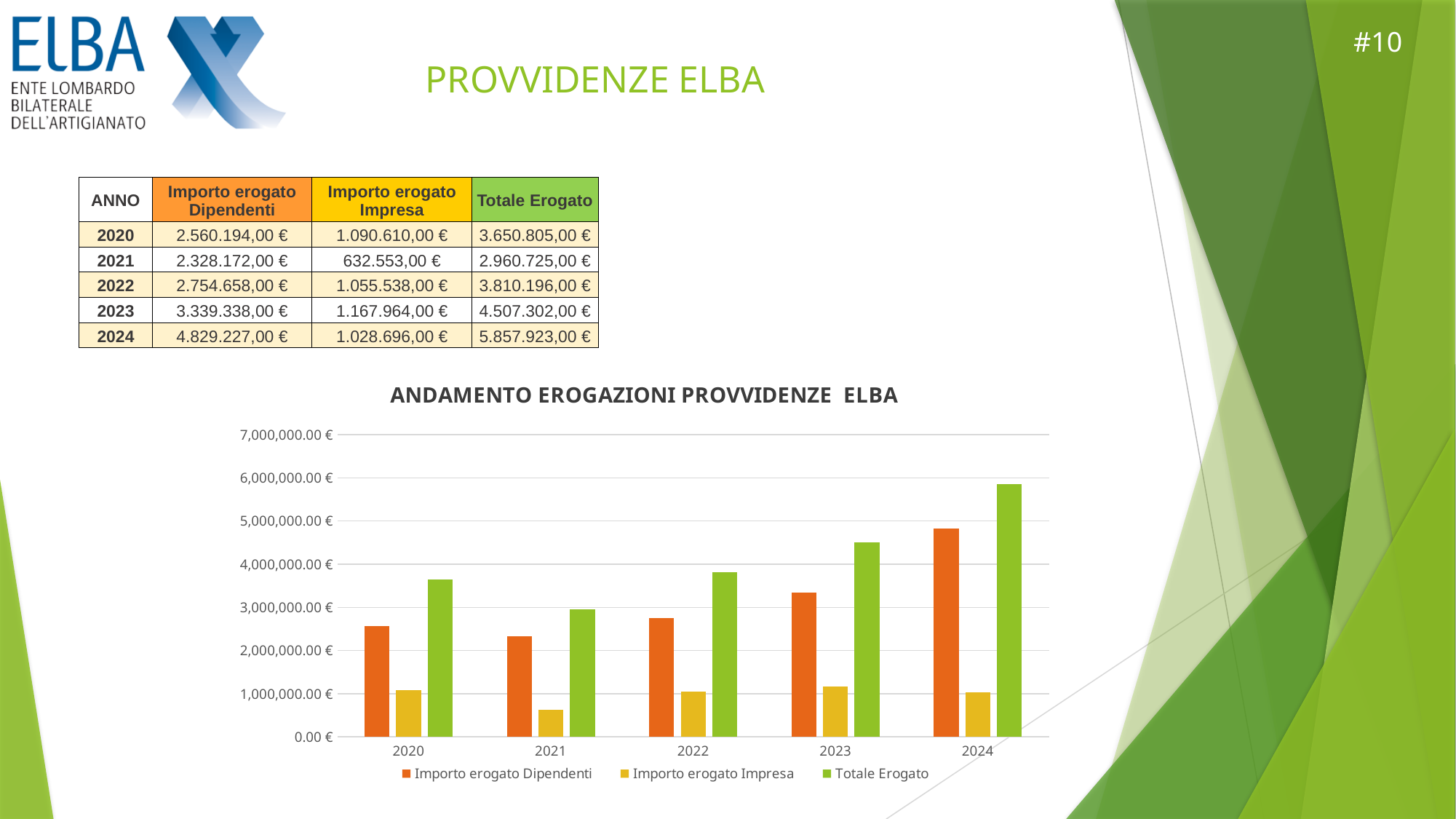
In which year is the Totale Erogato bar the lowest? 2021 How many series does the legend of the chart list? 3 What kind of chart is shown under the title "ANDAMENTO EROGAZIONI PROVVIDENZE ELBA"? Bar chart What is the Totale Erogato value for 2024, as printed in the table on the slide? 5.857.923,00 € Is the Importo erogato Impresa value for 2021 greater or less than 1,000,000.00 €? less In which year is the Importo erogato Impresa bar the lowest? 2021 In which year is the Totale Erogato bar the highest? 2024 Which is larger in 2023: Importo erogato Dipendenti or Importo erogato Impresa? Importo erogato Dipendenti How many years are shown on the x axis of the chart? 5 What is the Importo erogato Dipendenti value for 2020, as printed in the table on the slide? 2.560.194,00 € Does the Importo erogato Dipendenti series rise or fall from 2021 to 2024? rise Is the Totale Erogato value for 2024 greater or less than 5,000,000.00 €? greater